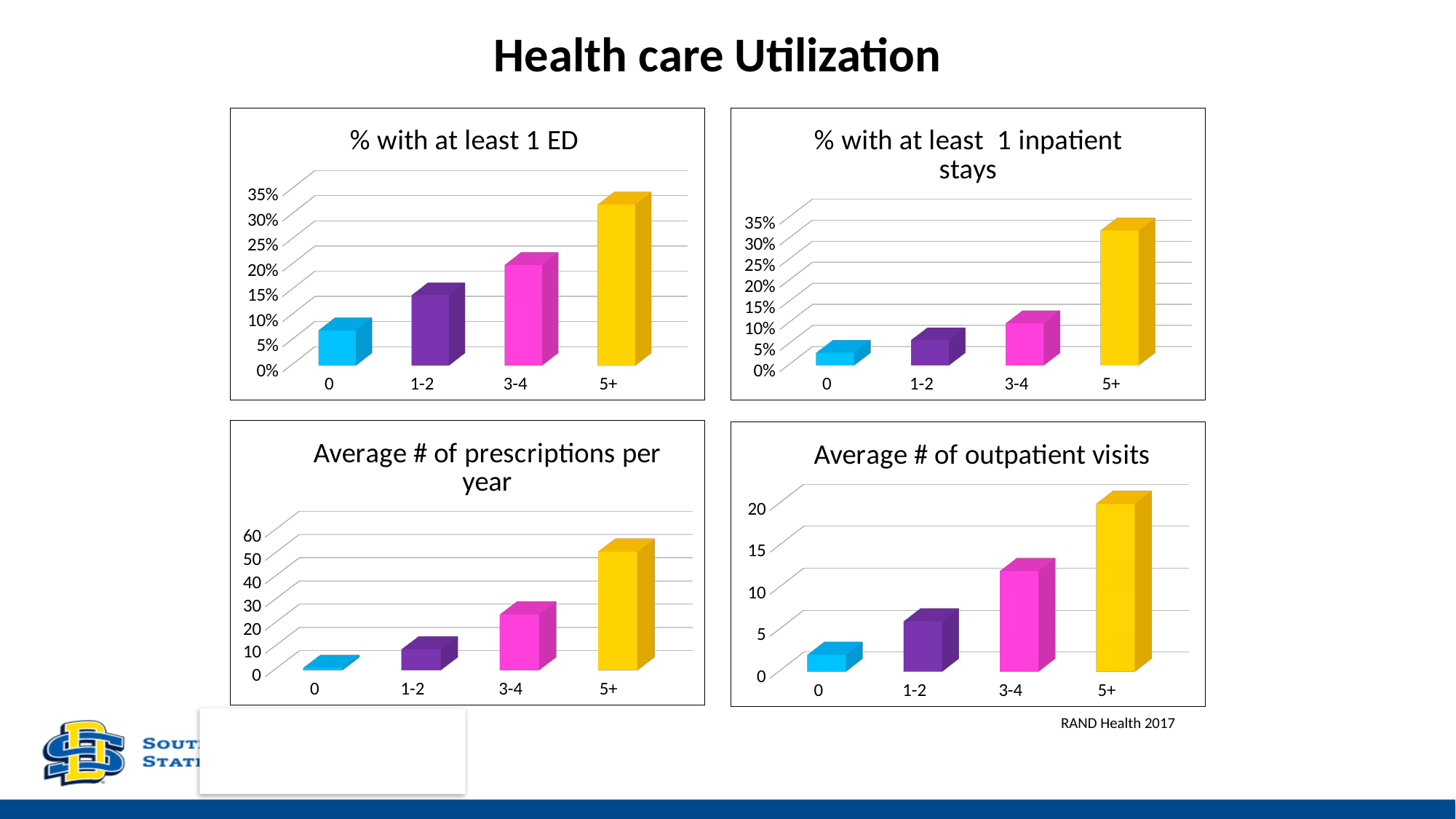
In the '% with at least 1 ED' chart, which category has the highest value? 5+ How many categories are shown on the x axis of the 'Average # of outpatient visits' chart? 4 How many charts are shown on the slide? 4 In the 'Average # of prescriptions per year' chart, do the values rise or fall from left to right along the x axis? rise What kind of chart is the '% with at least 1 ED' chart? bar chart In the '% with at least 1 ED' chart, which category has the lowest value? 0 In the 'Average # of outpatient visits' chart, which category has the lowest value? 0 In the '% with at least 1 inpatient stays' chart, which is larger, the value for 1-2 or the value for 3-4? 3-4 In the '% with at least 1 inpatient stays' chart, is the value for 5+ greater or less than 25%? greater In the 'Average # of prescriptions per year' chart, is the value for 5+ greater or less than 40? greater In the '% with at least 1 ED' chart, is the value for 5+ greater or less than 25%? greater